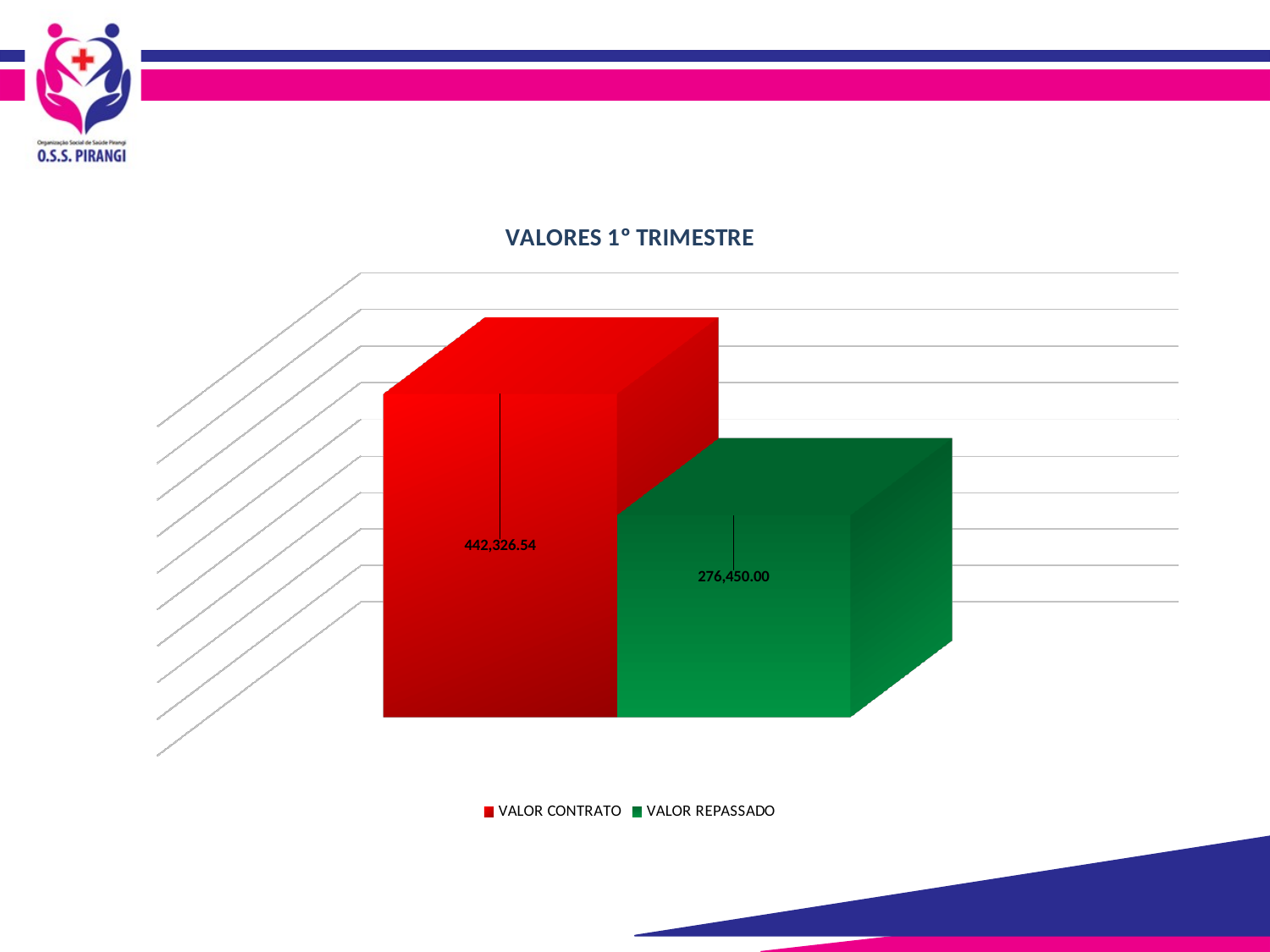
What kind of chart is shown on the slide? Bar chart What is the value for VALOR CONTRATO? 442,326.54 What is the value for VALOR REPASSADO? 276,450.00 What colour represents VALOR REPASSADO in the legend? Green Which series has the highest value? VALOR CONTRATO Which series has the lowest value? VALOR REPASSADO What is the difference between VALOR CONTRATO and VALOR REPASSADO? 165,876.54 How many bars are plotted in the chart? 2 How many series does the legend list? 2 What is the title of the chart? VALORES 1° TRIMESTRE Which is larger, VALOR CONTRATO or VALOR REPASSADO? VALOR CONTRATO